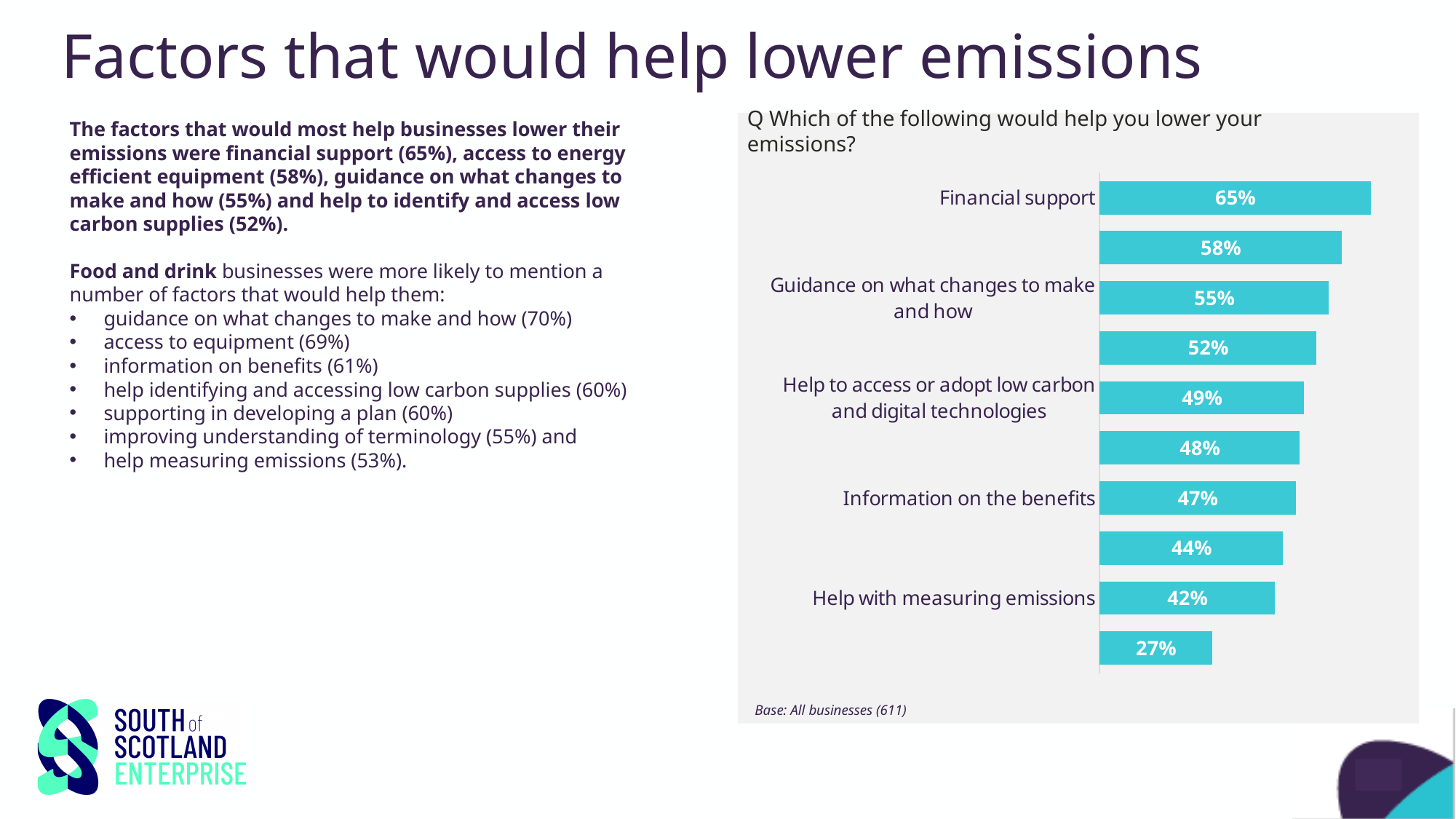
Which is larger: the value for 'Guidance on what changes to make and how' or the value for 'Information on the benefits'? Guidance on what changes to make and how Which factor has the highest value in the chart? Financial support What is the value for 'Help to access or adopt low carbon and digital technologies'? 49% What is the value for 'Information on the benefits'? 47% What is the lowest value shown on any bar in the chart? 27% How many bars are plotted in the chart? 10 What percentage of businesses said financial support would help them lower their emissions? 65% What type of chart is shown on the slide? Bar chart What is the value for 'Help with measuring emissions'? 42% What is the difference between the values for 'Financial support' and 'Help with measuring emissions'? 23 percentage points What base is stated beneath the chart? All businesses (611) What is the value for 'Guidance on what changes to make and how'? 55%